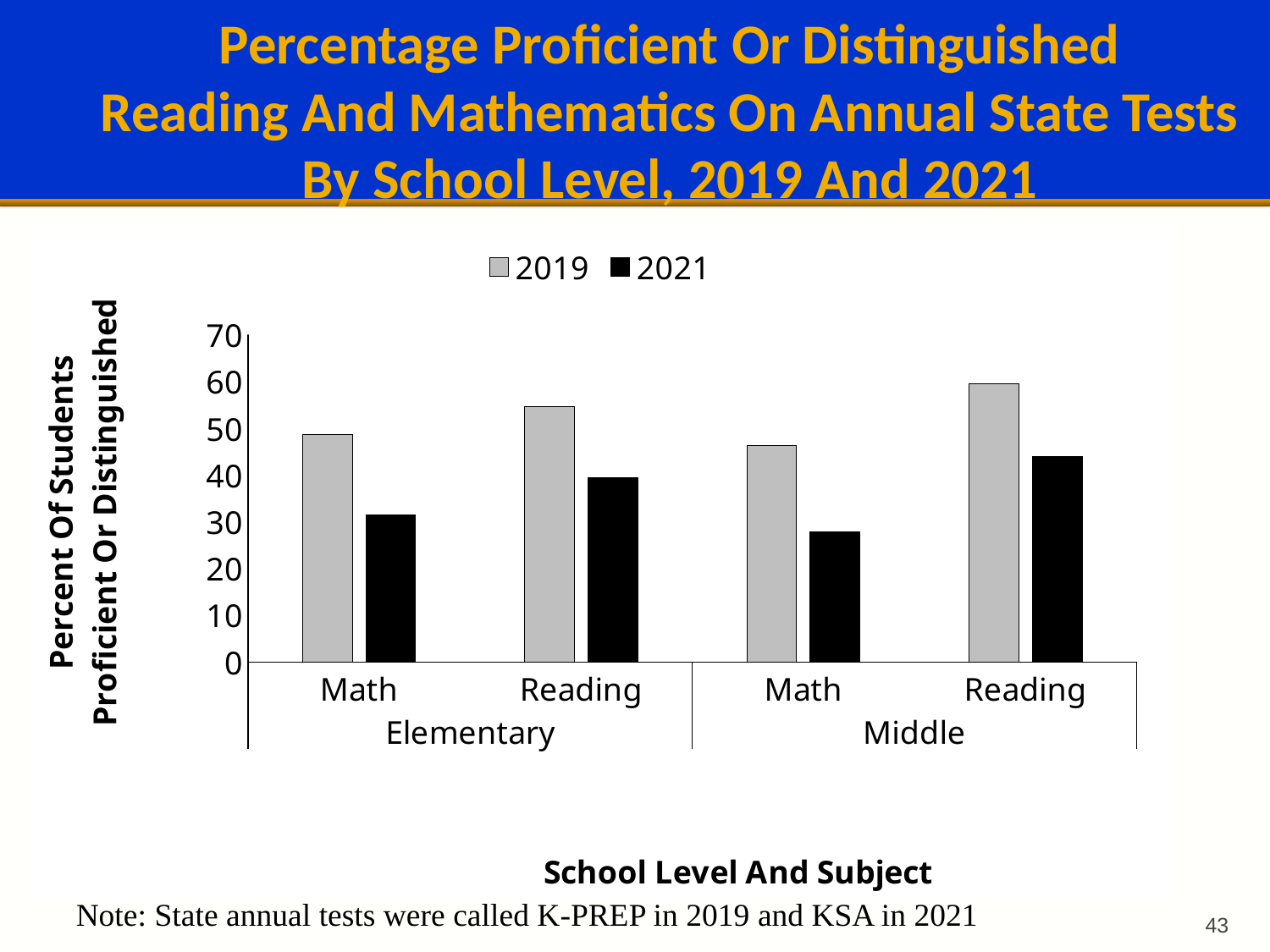
In every category, is the 2021 bar higher or lower than the 2019 bar? lower Is the 2019 value for Elementary Math greater or less than 40? greater How many school level and subject categories are plotted on the x axis? 4 Is the 2021 value for Middle Math greater or less than 40? less Which category has the lowest 2021 value? Middle Math How many series does the legend list? 2 Is the 2021 value for Elementary Math greater or less than 40? less For Elementary Math, which year has the larger value, 2019 or 2021? 2019 What is the label of the y axis? Percent Of Students Proficient Or Distinguished What kind of chart is shown on the slide? bar chart Which category has the highest 2019 value? Middle Reading